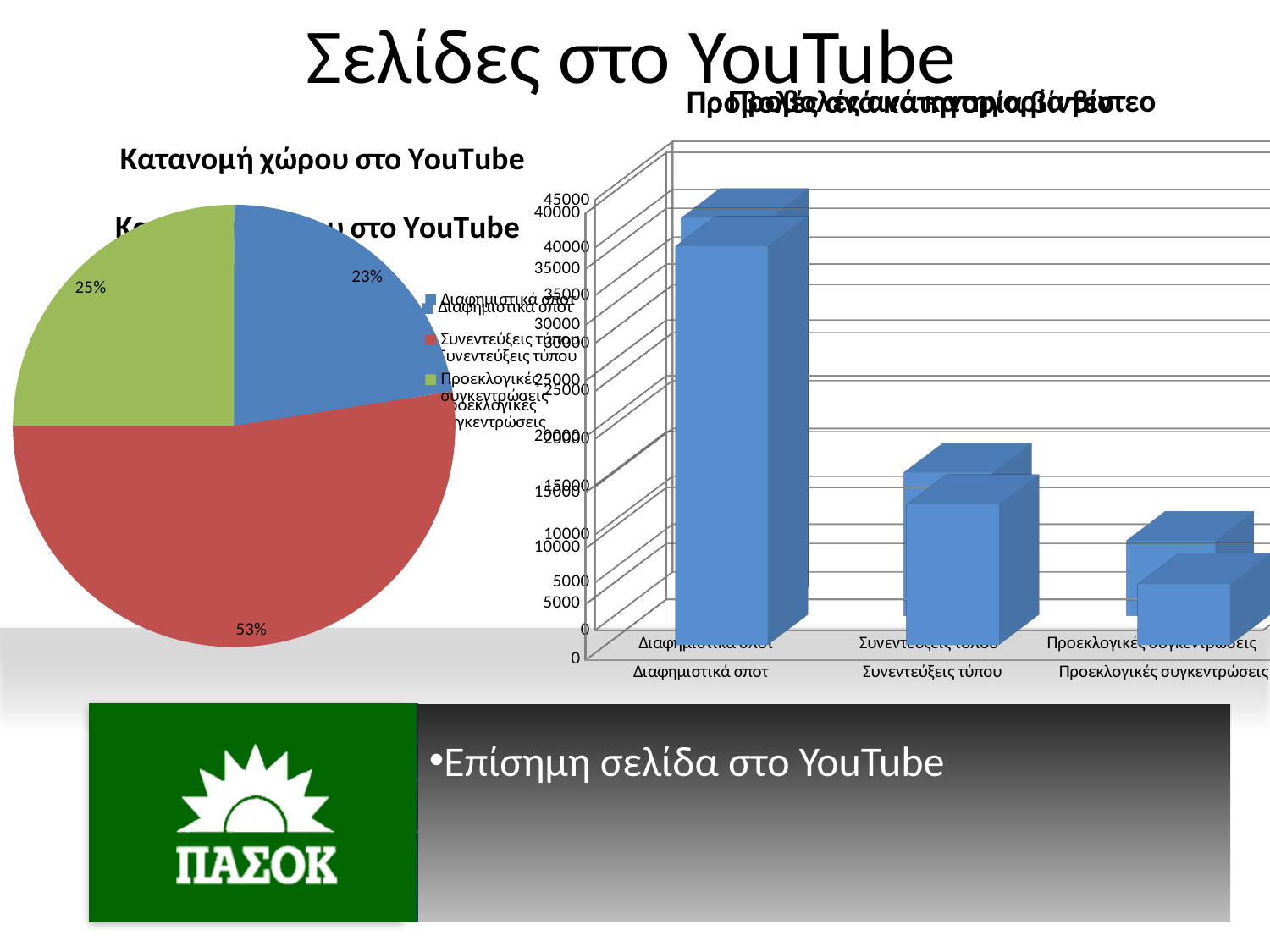
In the pie chart, what is the difference in percentage points between Συνεντεύξεις τύπου and Προεκλογικές συγκεντρώσεις? 28 In the pie chart, which category has the largest slice? Συνεντεύξεις τύπου What is the title of the pie chart? Κατανομή χώρου στο YouTube In the bar chart, is the value for Προεκλογικές συγκεντρώσεις greater or less than 10000? less In the pie chart, which category has the smallest slice? Διαφημιστικά σποτ What kind of chart is the chart on the right side of the slide? bar chart In the pie chart, what share does Προεκλογικές συγκεντρώσεις have? 25% In the pie chart, what share does Διαφημιστικά σποτ have? 23% In the pie chart, what share does Συνεντεύξεις τύπου have? 53% In the bar chart, which category has the lowest bar? Προεκλογικές συγκεντρώσεις How many entries does the legend of the pie chart list? 3 In the bar chart, which category has the highest bar? Διαφημιστικά σποτ